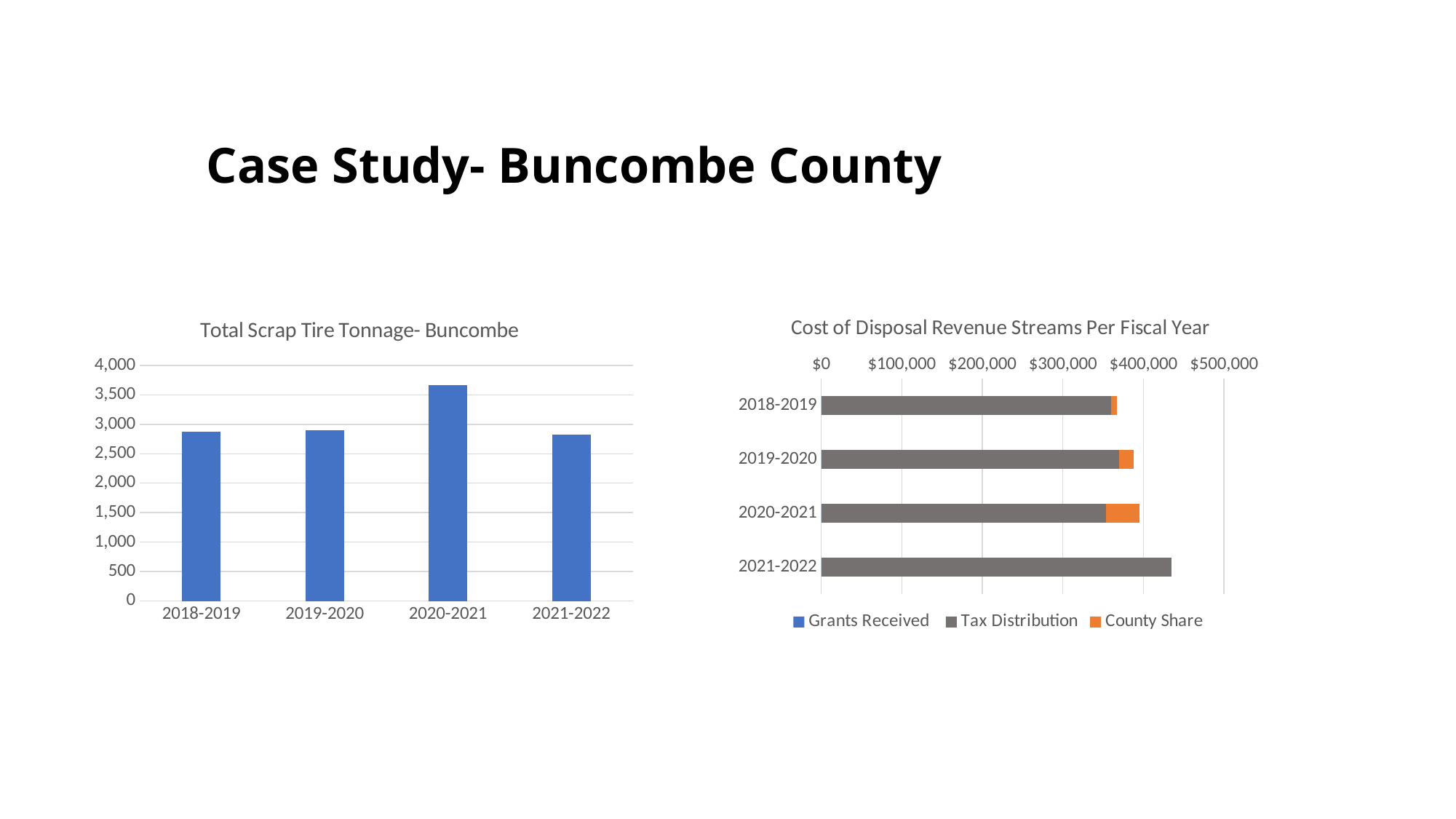
In the "Cost of Disposal Revenue Streams Per Fiscal Year" chart, is the Tax Distribution for 2021-2022 greater or less than $400,000? greater In the "Total Scrap Tire Tonnage- Buncombe" chart, which is larger, the value for 2020-2021 or the value for 2021-2022? 2020-2021 In the "Cost of Disposal Revenue Streams Per Fiscal Year" chart, what colour represents County Share? orange In the "Total Scrap Tire Tonnage- Buncombe" chart, is the value for 2018-2019 greater or less than 3,000? less In the "Cost of Disposal Revenue Streams Per Fiscal Year" chart, how many series does the legend list? 3 In the "Cost of Disposal Revenue Streams Per Fiscal Year" chart, is the Tax Distribution for 2018-2019 greater or less than $400,000? less In the "Total Scrap Tire Tonnage- Buncombe" chart, which fiscal year has the highest tonnage? 2020-2021 What kind of chart is the "Total Scrap Tire Tonnage- Buncombe" chart? bar chart In the "Cost of Disposal Revenue Streams Per Fiscal Year" chart, which fiscal year has the largest County Share? 2020-2021 In the "Total Scrap Tire Tonnage- Buncombe" chart, how many fiscal years are shown? 4 In the "Cost of Disposal Revenue Streams Per Fiscal Year" chart, which fiscal year has the largest Tax Distribution? 2021-2022